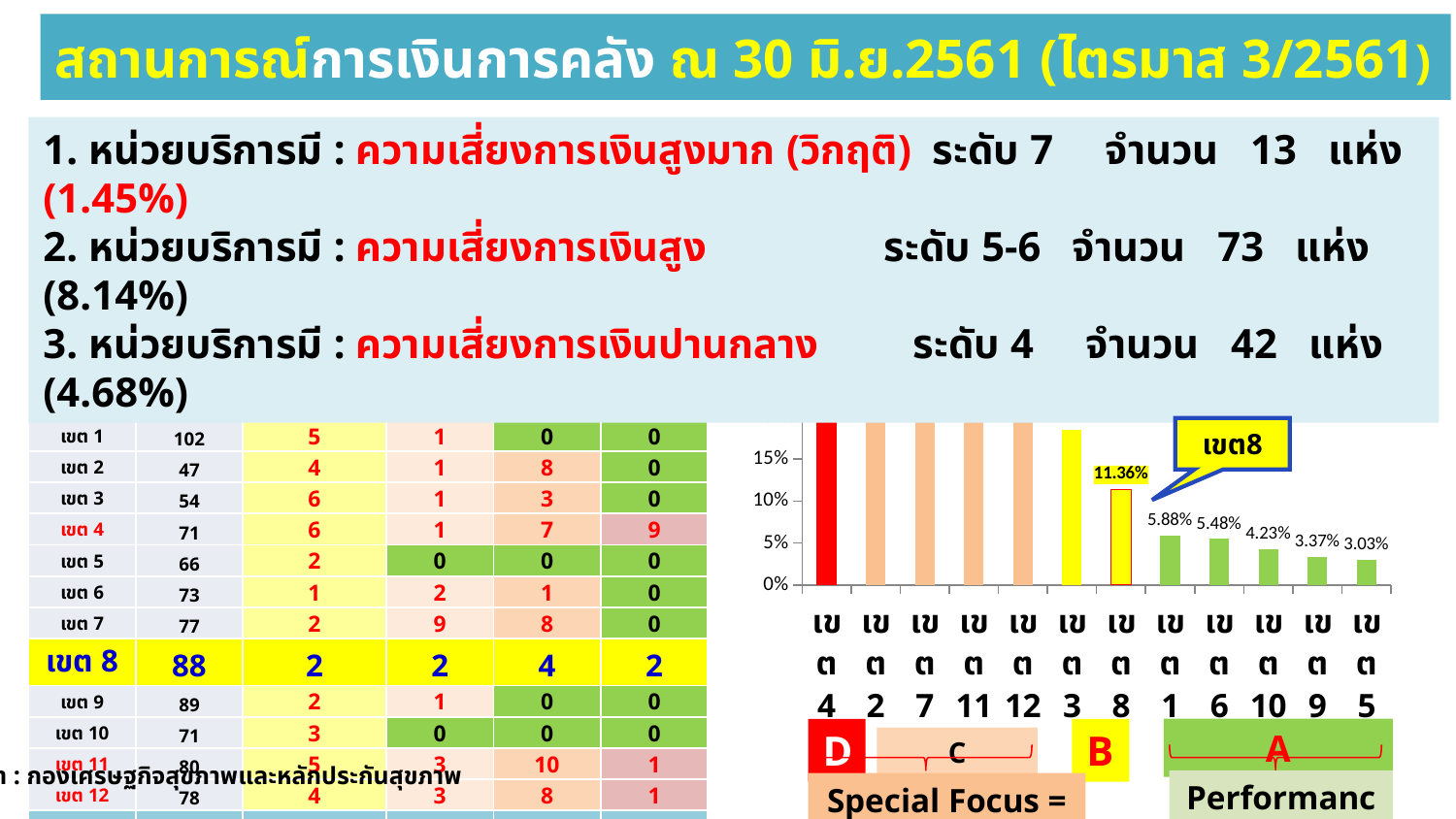
In the bar chart, do the values rise or fall from left to right along the x axis? fall In the bar chart, is the value for เขต 4 greater or less than 15%? greater In the bar chart, what is the value for เขต 1? 5.88% In the bar chart, what is the value for เขต 10? 4.23% In the bar chart, what is the value for เขต 8? 11.36% In the bar chart, what is the value for เขต 5? 3.03% What kind of chart is shown on the right side of the slide? bar chart How many categories (เขต) are shown in the bar chart? 12 In the bar chart, which is larger, the value for เขต 1 or the value for เขต 6? เขต 1 In the bar chart, which category has the lowest value? เขต 5 In the bar chart, what is the difference between the values for เขต 8 and เขต 1? 5.48% In the bar chart, what is the difference between the values for เขต 6 and เขต 9? 2.11%